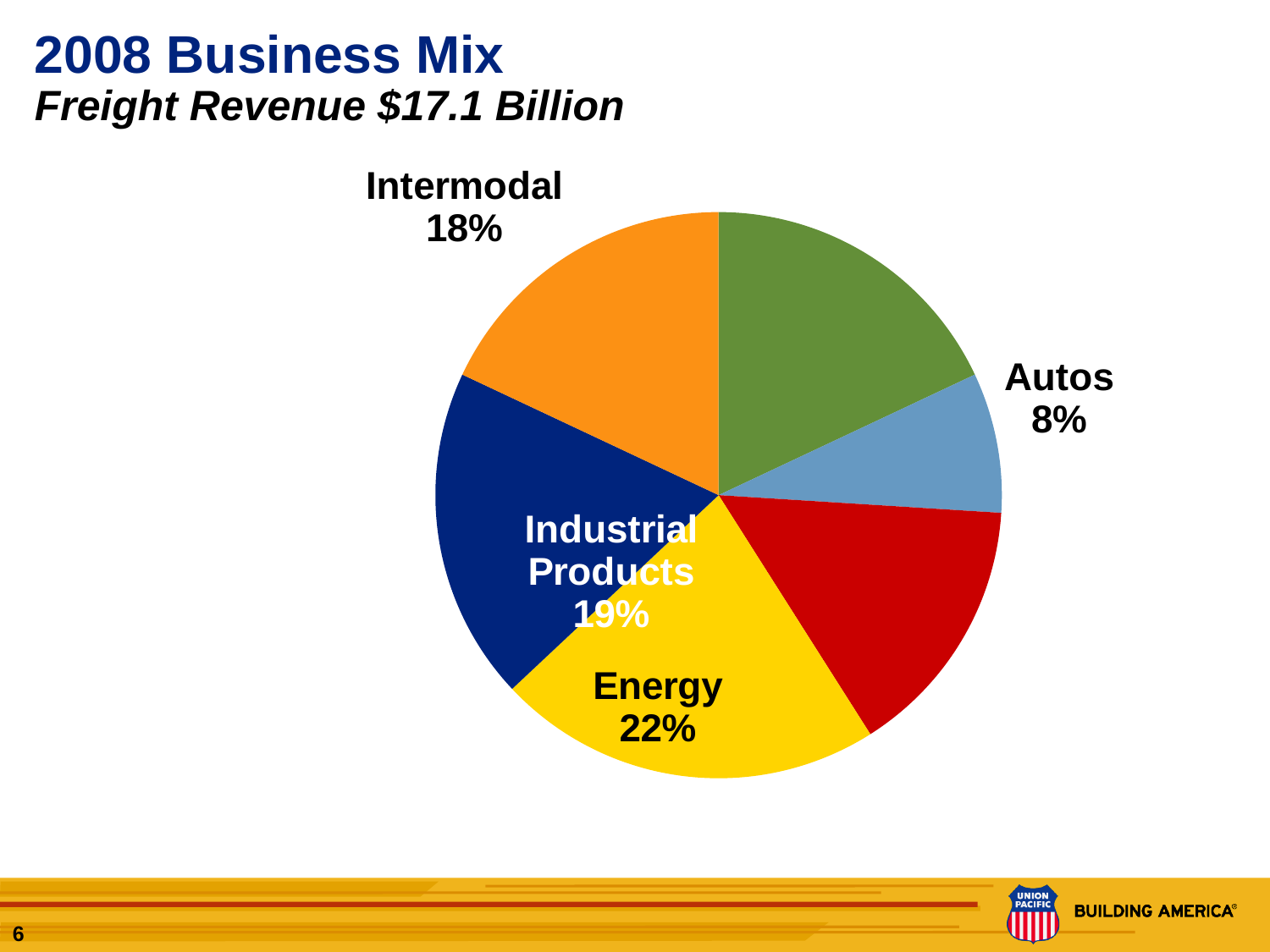
How many percentage points larger is Energy's share than Intermodal's? 4 What percentage is shown for Industrial Products? 19% What percentage is shown for Intermodal? 18% What kind of chart is shown on the slide? Pie chart What total freight revenue does the slide subtitle give for 2008? $17.1 Billion How many slices does the pie chart have? 6 How many percentage points larger is Energy's share than Autos' share? 14 Which labeled category has the smallest share of the pie? Autos Which labeled category has the largest share of the pie? Energy Which has the larger share, Industrial Products or Intermodal? Industrial Products What percentage is shown for Autos? 8% What share of freight revenue does Energy account for in the pie chart? 22%